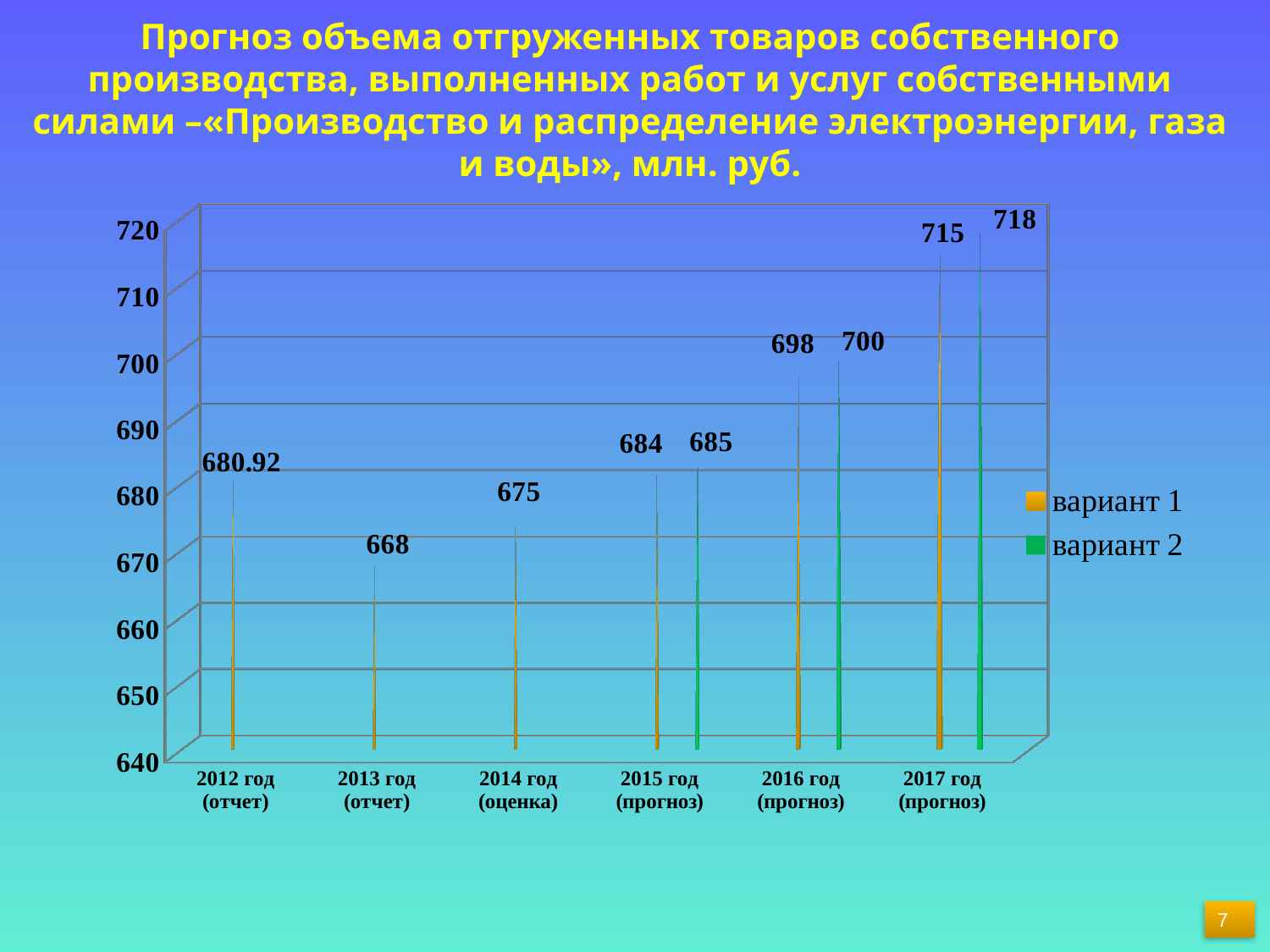
What is the difference between вариант 2 and вариант 1 in 2017 год (прогноз)? 3 What is the value for вариант 1 in 2015 год (прогноз)? 684 What is the value shown for 2012 год (отчет)? 680.92 What is the value for вариант 2 in 2017 год (прогноз)? 718 How many year categories are shown on the x axis? 6 What type of chart is shown on the slide? bar chart What is the value for вариант 2 in 2016 год (прогноз)? 700 Which year and series has the highest value on the chart? 2017 год (прогноз), вариант 2 What is the difference between the values for 2014 год (оценка) and 2013 год (отчет)? 7 Which year has the lowest value on the chart? 2013 год (отчет) How many series does the legend list? 2 Which is larger in 2016 год (прогноз): вариант 1 or вариант 2? вариант 2